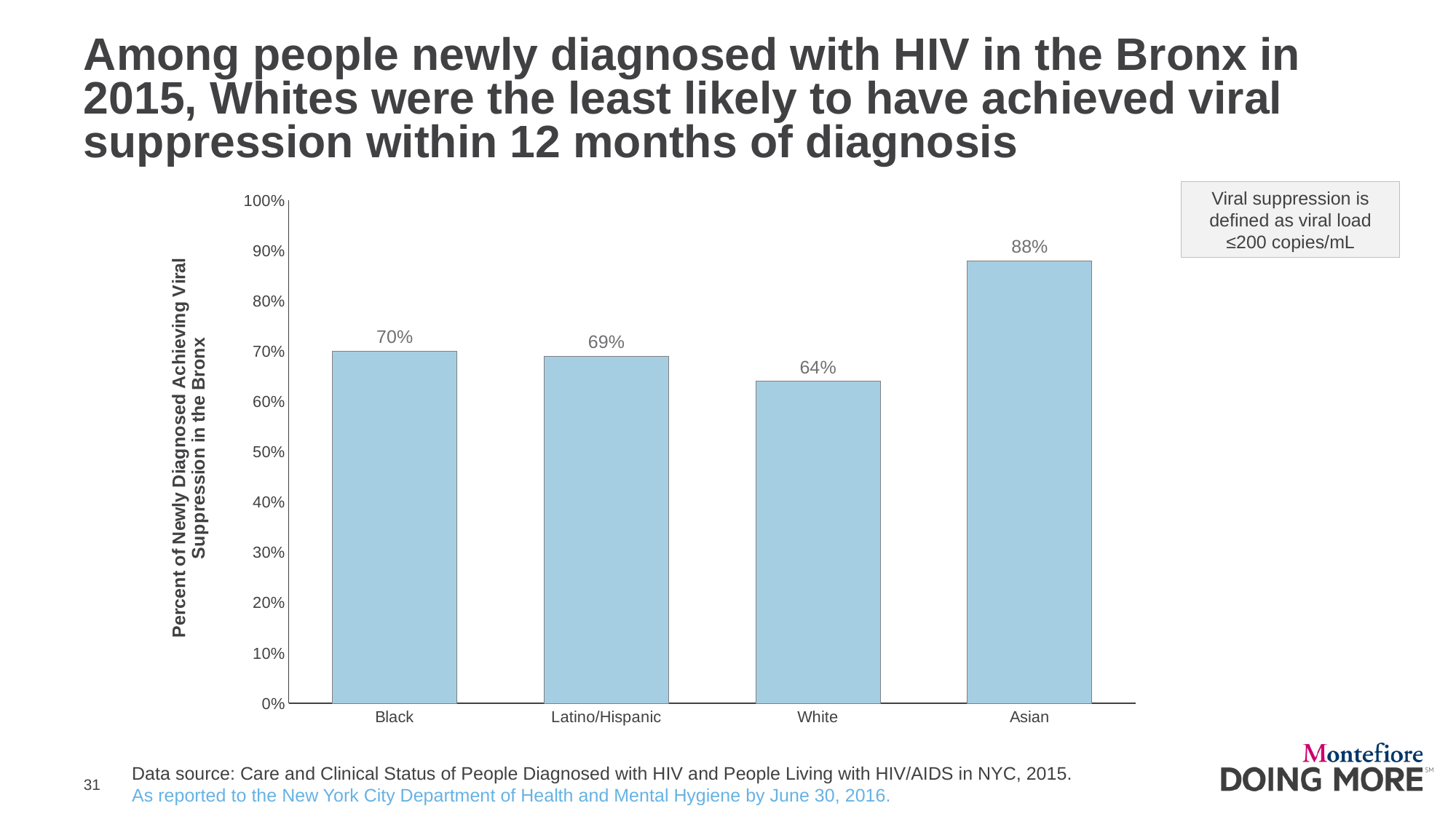
What kind of chart is shown on the slide? Bar chart What is the value shown for Latino/Hispanic? 69% What is the difference between the Black and Latino/Hispanic values? 1% Which group has the highest percent achieving viral suppression? Asian Which is larger, the value for Asian or the value for Black? Asian What percent of newly diagnosed Black people achieved viral suppression? 70% What is the value shown for Asian? 88% What is the difference between the Asian and White values? 24% What is the value shown for White? 64% Which group has the lowest percent achieving viral suppression? White What is the label of the y axis? Percent of Newly Diagnosed Achieving Viral Suppression in the Bronx How many groups are shown on the x axis? 4